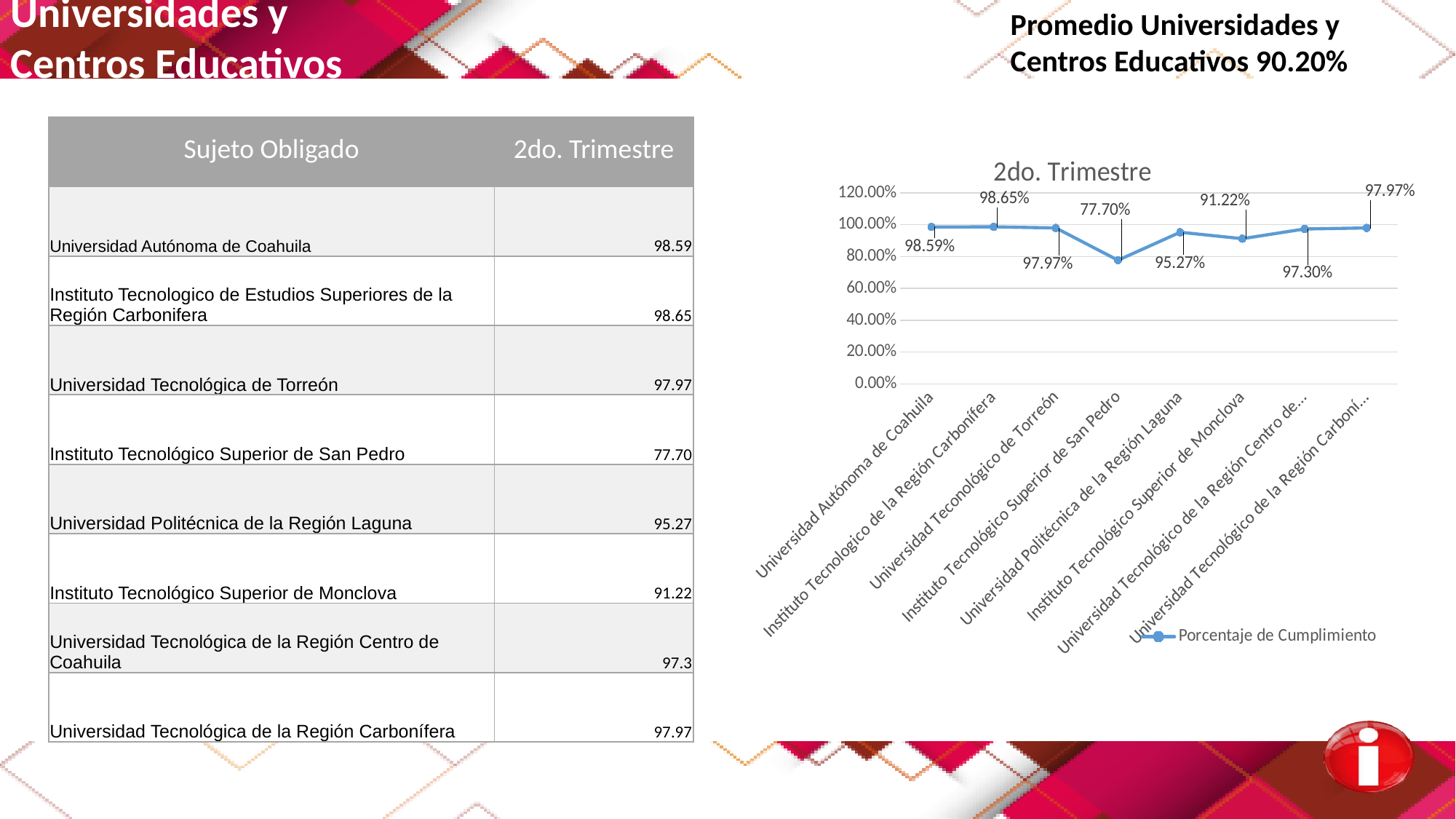
Which category has the lowest value on the chart? Instituto Tecnológico Superior de San Pedro What is the value for Instituto Tecnológico Superior de Monclova? 91.22% What is the value for Universidad Autónoma de Coahuila? 98.59% What kind of chart is shown on the slide? line chart What is the value for Instituto Tecnológico Superior de San Pedro? 77.70% How many series does the chart legend list? 1 Which category has the highest value on the chart? Instituto Tecnologico de la Región Carbonífera What is the difference between the values for Universidad Politécnica de la Región Laguna and Instituto Tecnológico Superior de San Pedro? 17.57% Which is larger, the value for Universidad Politécnica de la Región Laguna or the value for Instituto Tecnológico Superior de Monclova? Universidad Politécnica de la Región Laguna What is the title of the chart? 2do. Trimestre What series name does the chart legend list? Porcentaje de Cumplimiento How many data points are plotted on the chart? 8